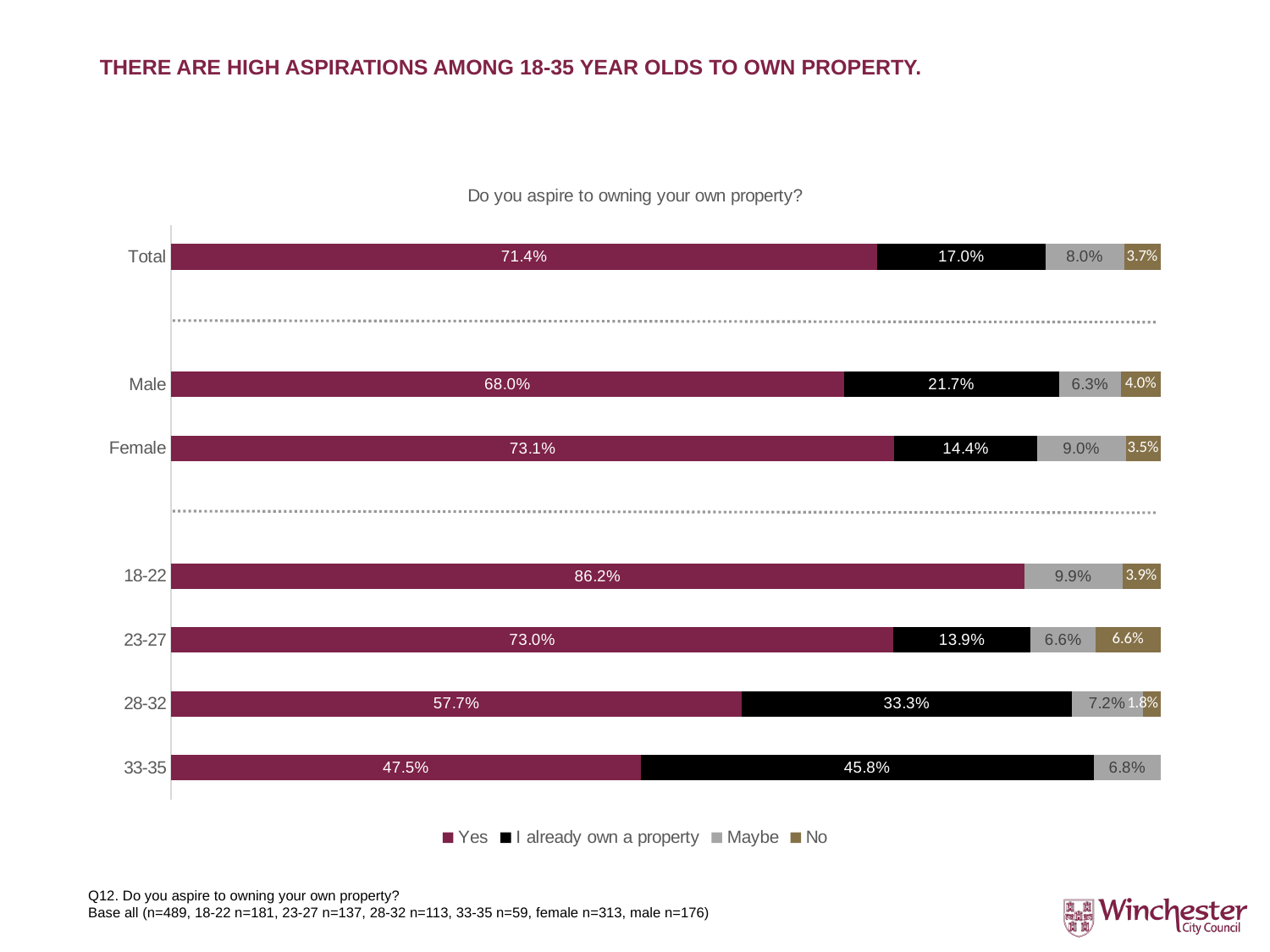
How many categories (bars) are shown on the chart? 7 What is the "No" value for the 23-27 age group? 6.6% What percentage of 28-32 year olds said "I already own a property"? 33.3% What is the title of the chart? Do you aspire to owning your own property? Which group has a larger "I already own a property" share, Male or Female? Male Which category has the lowest "Yes" percentage? 33-35 What is the "Maybe" value for Female respondents? 9.0% What type of chart is shown on the slide? Stacked bar chart How many series does the legend list? 4 Which category has the highest "Yes" percentage? 18-22 How many percentage points higher is the "Yes" value for Female than for Male? 5.1 percentage points What percentage of the Total group answered "Yes" to aspiring to own their own property? 71.4%